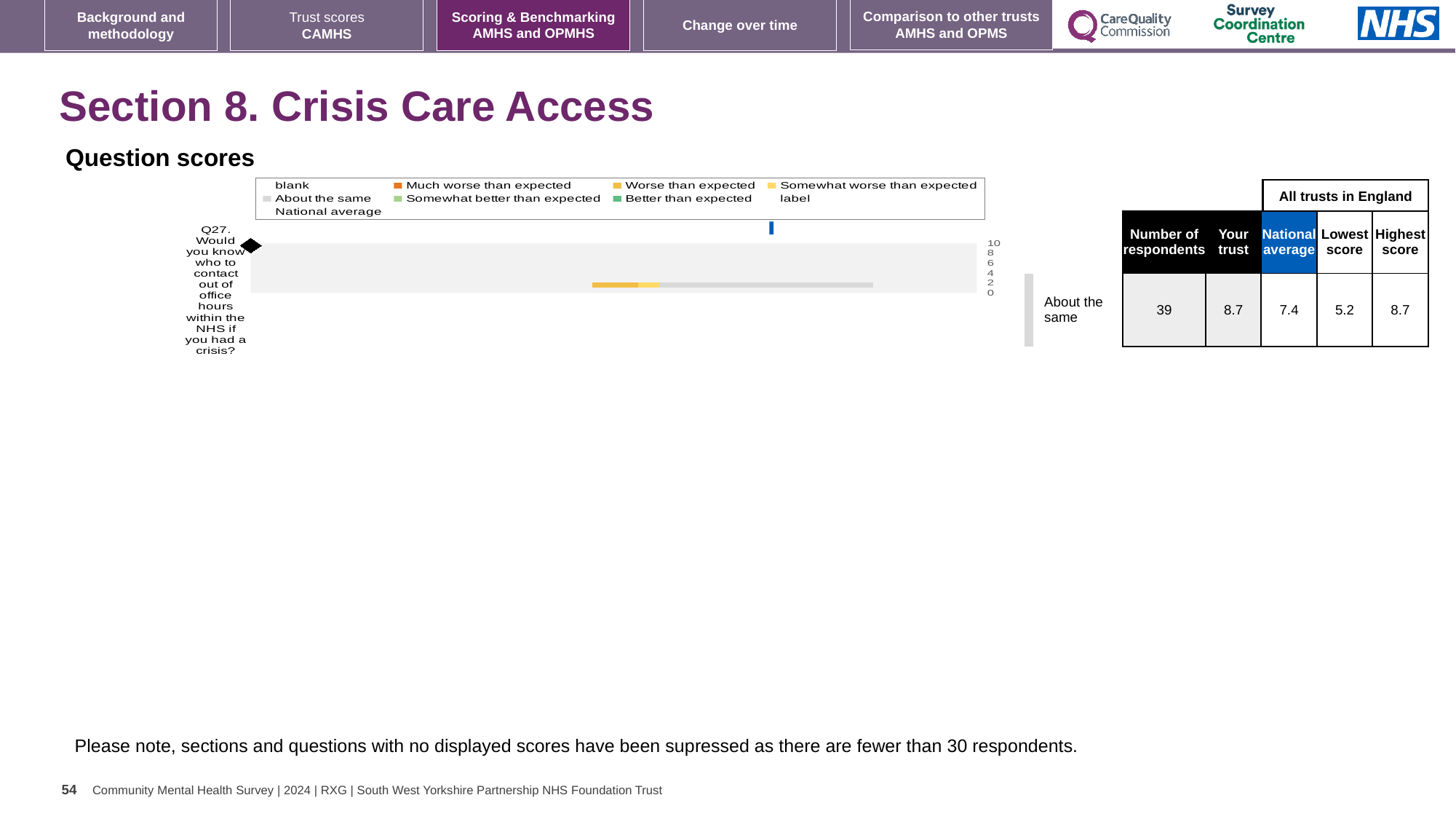
Which is larger for Q27 in the table beside the chart: the 'Your trust' score or the National average? Your trust In the table beside the chart, how many respondents are listed for Q27? 39 In the table beside the chart, what is the 'Your trust' score for Q27? 8.7 In the table beside the chart, what is the Highest score among all trusts in England for Q27? 8.7 By how much does the 'Your trust' score for Q27 exceed the National average in the table beside the chart? 1.3 What kind of chart is shown under 'Question scores'? bar chart Which question is plotted in the Question scores chart? Q27. Would you know who to contact out of office hours within the NHS if you had a crisis? In the table beside the chart, what is the National average for Q27? 7.4 In the table beside the chart, what is the Lowest score among all trusts in England for Q27? 5.2 What benchmark label is shown to the right of the bar for Q27? About the same What is the highest value shown on the chart's score axis? 10 How many questions (categories) are plotted in the Question scores chart? 1